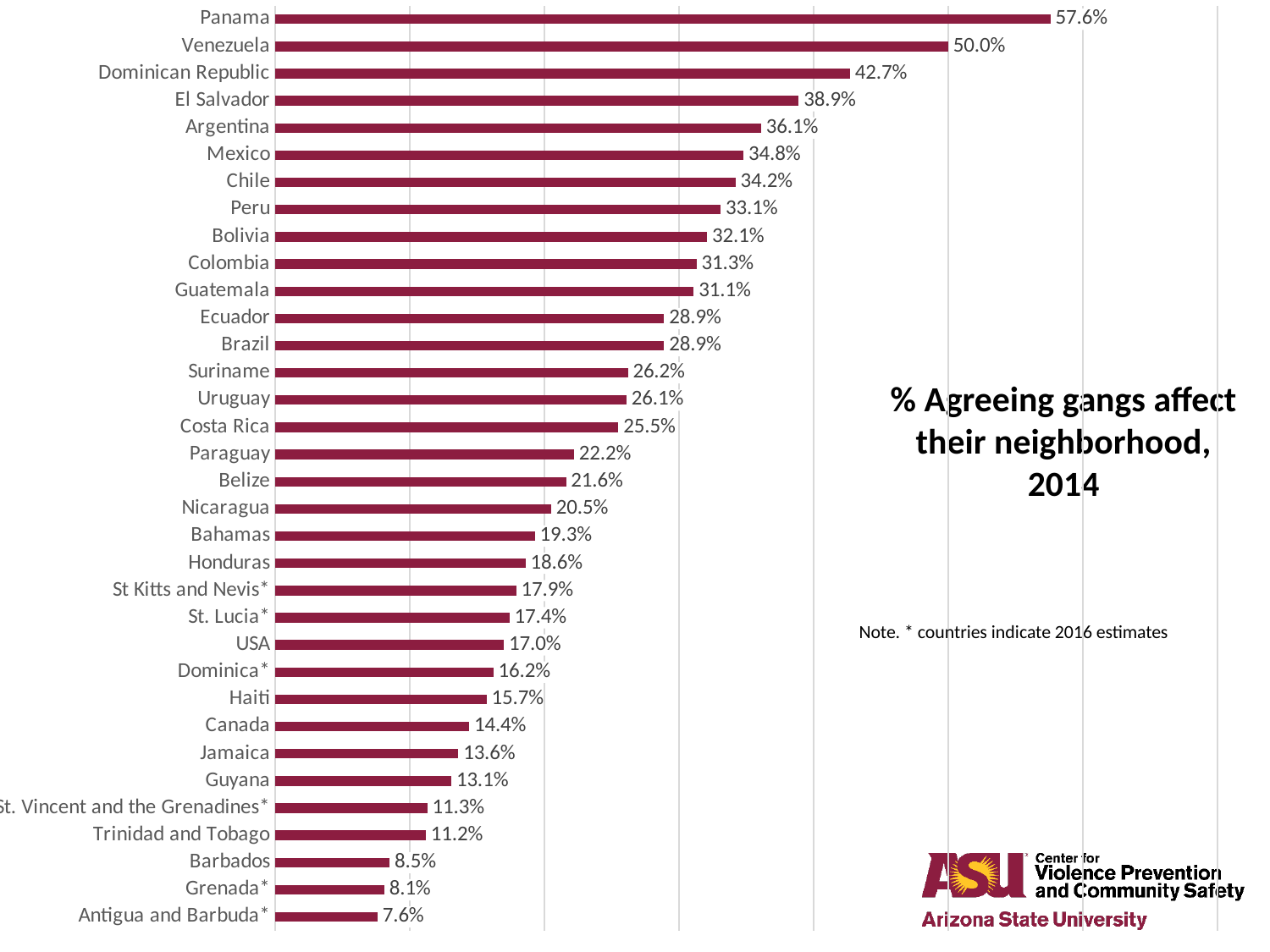
How many countries are shown in the chart? 34 According to the note on the slide, what do the asterisks next to country names indicate? 2016 estimates Which country has the lowest percentage agreeing gangs affect their neighborhood? Antigua and Barbuda* Which has a higher value, Canada or Haiti? Haiti What is the difference between the values for Venezuela and Dominican Republic? 7.3% What percentage of respondents in Panama agree that gangs affect their neighborhood? 57.6% Which country has the highest percentage agreeing gangs affect their neighborhood? Panama What kind of chart is shown on the slide? Bar chart What is the value shown for Trinidad and Tobago? 11.2% What is the title of the chart? % Agreeing gangs affect their neighborhood, 2014 What is the value shown for Mexico? 34.8% What is the value shown for the USA? 17.0%